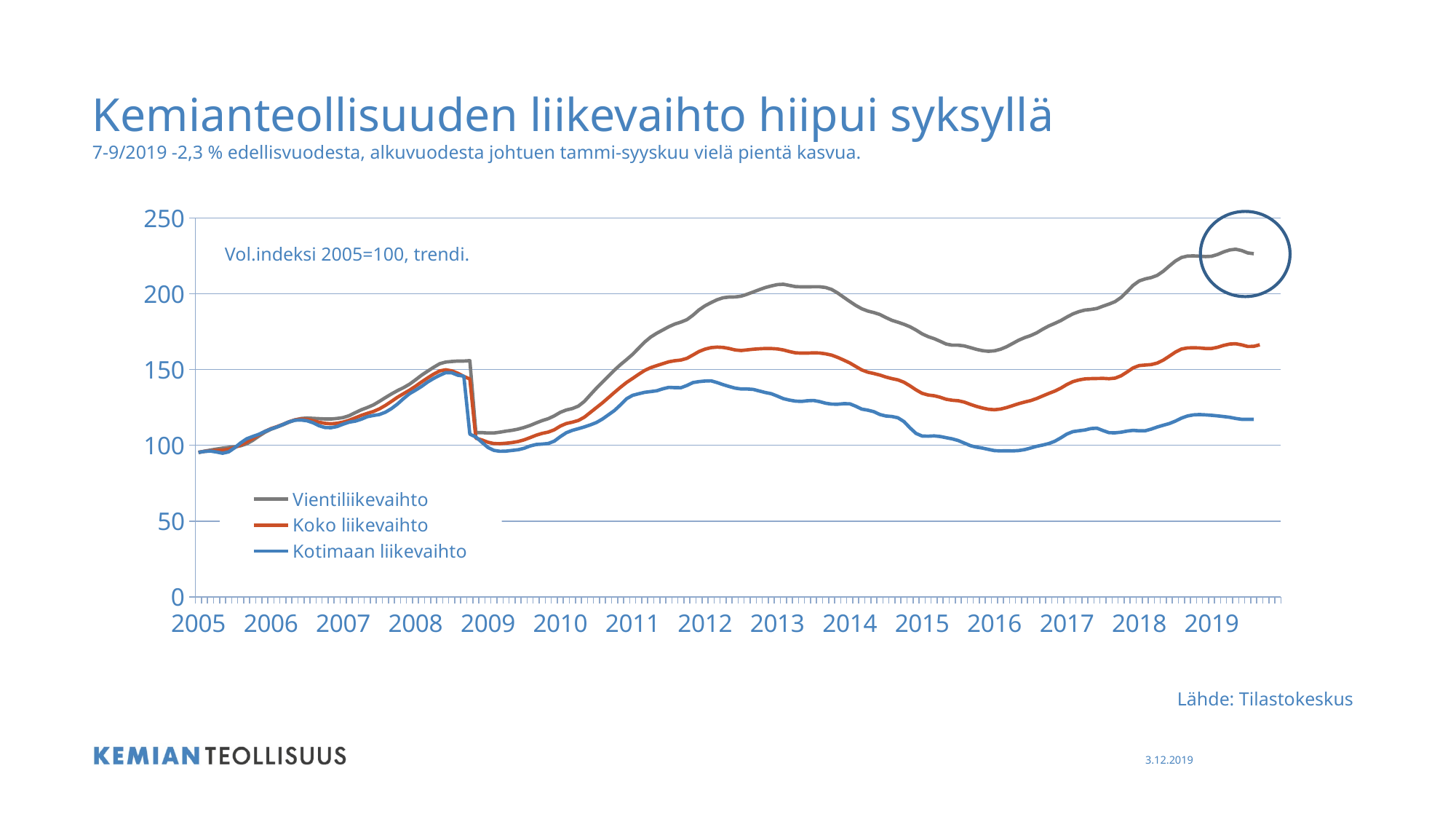
What kind of chart is shown on the slide? line chart Which series has the lowest value at the end of 2019? Kotimaan liikevaihto Is the value for Vientiliikevaihto in 2016 greater or less than 150? greater Is the value for Koko liikevaihto in 2013 greater or less than 150? greater How many series does the chart legend list? 3 How many year labels are shown on the x axis of the chart? 15 Which series has the highest value at the end of 2019? Vientiliikevaihto Does Vientiliikevaihto rise or fall between 2016 and 2018? rise Is the value for Vientiliikevaihto in 2019 greater or less than 200? greater Which series is drawn in red in the chart? Koko liikevaihto In 2013, which is larger: Koko liikevaihto or Kotimaan liikevaihto? Koko liikevaihto